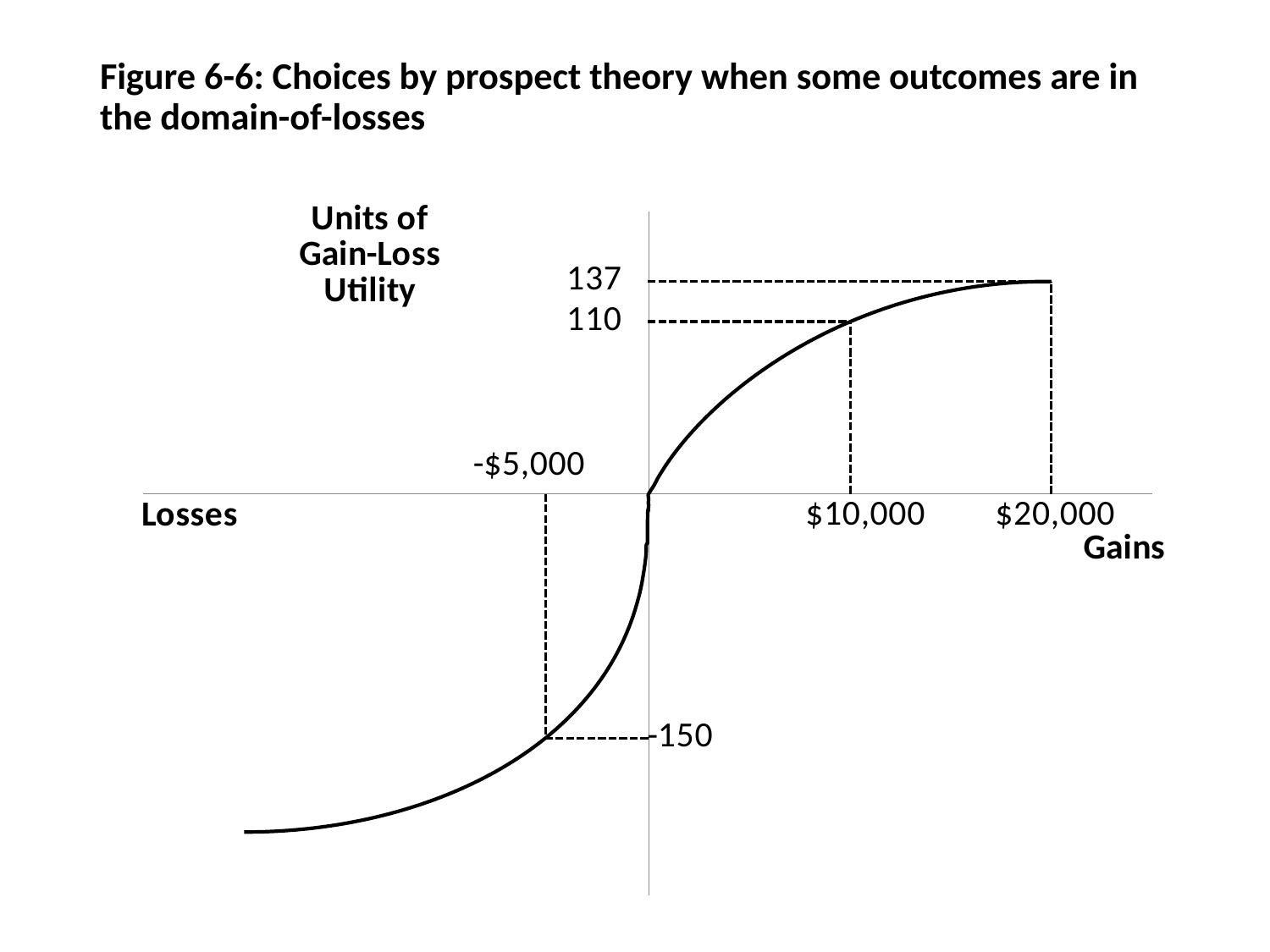
What is the gain-loss utility for a loss of -$5,000? -150 How many labelled dollar outcomes are marked on the x axis? 3 Which of the three labelled outcomes has the highest gain-loss utility? $20,000 What is the difference in gain-loss utility between a gain of $20,000 and a gain of $10,000? 27 What is the gain-loss utility for a gain of $20,000? 137 Which gain yields the higher gain-loss utility, $10,000 or $20,000? $20,000 What is the figure number and title of the chart? Figure 6-6: Choices by prospect theory when some outcomes are in the domain-of-losses What kind of chart is shown on the slide? line chart What is the label of the vertical axis? Units of Gain-Loss Utility What is the gain-loss utility for a gain of $10,000? 110 Does the gain-loss utility rise or fall as gains increase along the x axis? rise Which of the three labelled outcomes has the lowest gain-loss utility? -$5,000